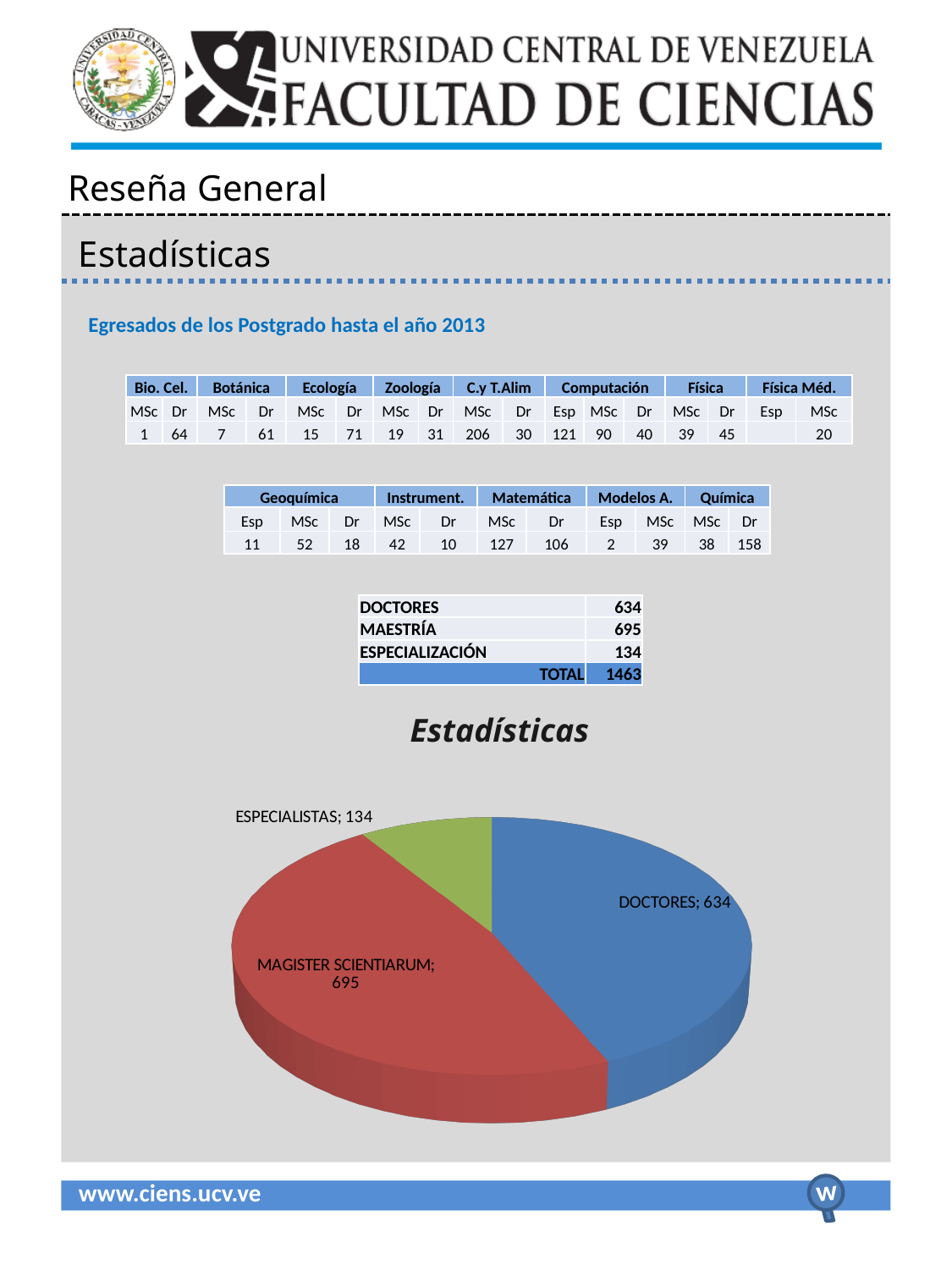
What is the title of the chart? Estadísticas Which slice of the pie chart is the largest? MAGISTER SCIENTIARUM What kind of chart is shown on the slide? pie chart Which is larger in the pie chart, DOCTORES or ESPECIALISTAS? DOCTORES What is the value for DOCTORES in the pie chart? 634 What is the value for ESPECIALISTAS in the pie chart? 134 What is the difference between the MAGISTER SCIENTIARUM and DOCTORES values in the pie chart? 61 What is the value for MAGISTER SCIENTIARUM in the pie chart? 695 How many slices does the pie chart have? 3 What colour is the DOCTORES slice in the pie chart? blue Which slice of the pie chart is the smallest? ESPECIALISTAS What is the total of all slices in the pie chart? 1463